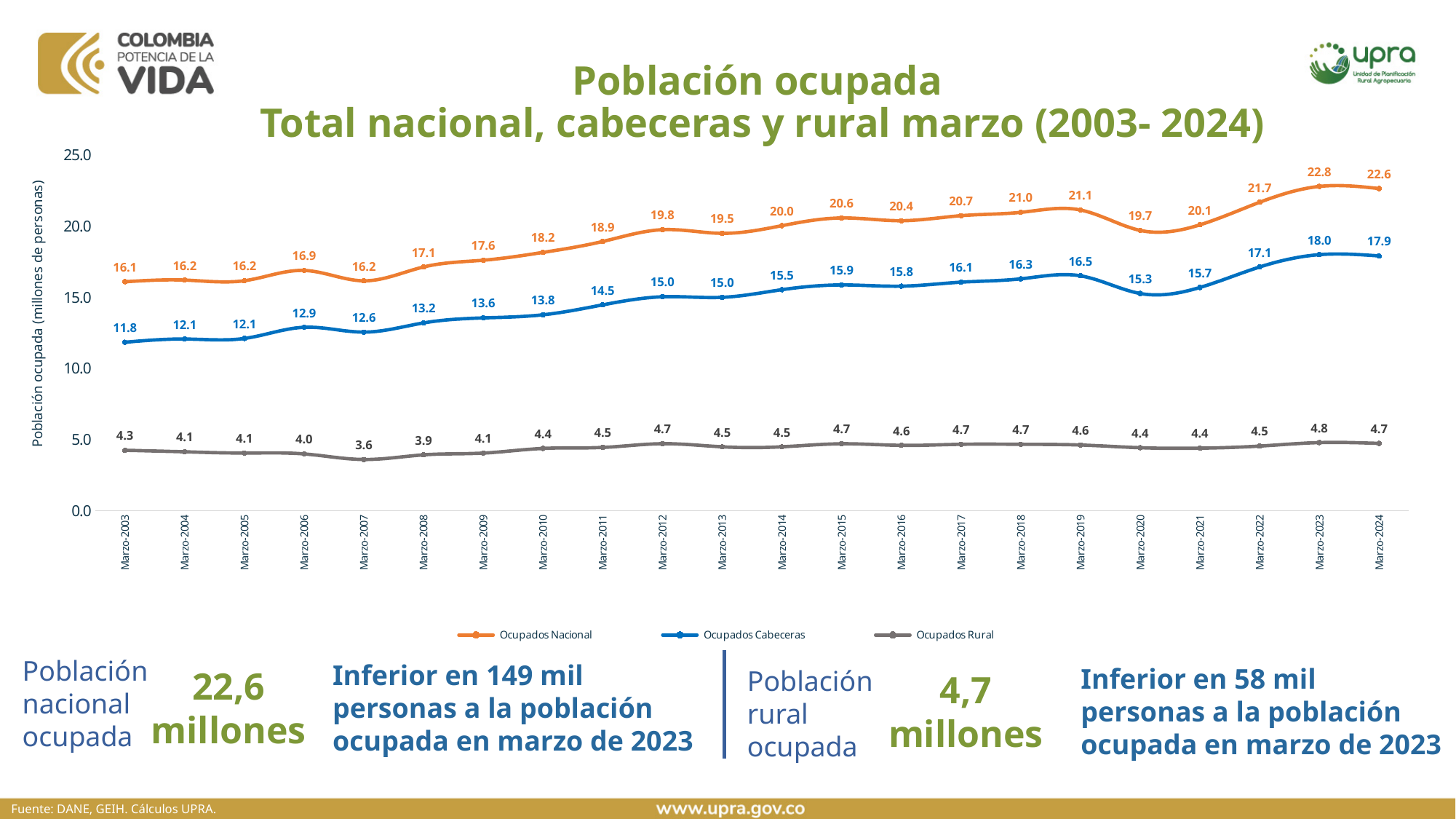
What is the value of Ocupados Rural for Marzo-2012? 4.7 What colour is the line for Ocupados Rural? grey Overall, does Ocupados Cabeceras rise or fall from Marzo-2003 to Marzo-2024? rise What is the value of Ocupados Nacional for Marzo-2024? 22.6 In which year does Ocupados Rural reach its lowest value? Marzo-2007 What is the difference between Ocupados Nacional and Ocupados Cabeceras in Marzo-2024? 4.7 How many series does the legend list? 3 What type of chart is shown on the slide? line chart How many time points (years) are plotted along the x axis? 22 In which year does Ocupados Nacional reach its highest value? Marzo-2023 What is the value of Ocupados Cabeceras for Marzo-2003? 11.8 Which is larger, Ocupados Nacional in Marzo-2019 or in Marzo-2020? Marzo-2019